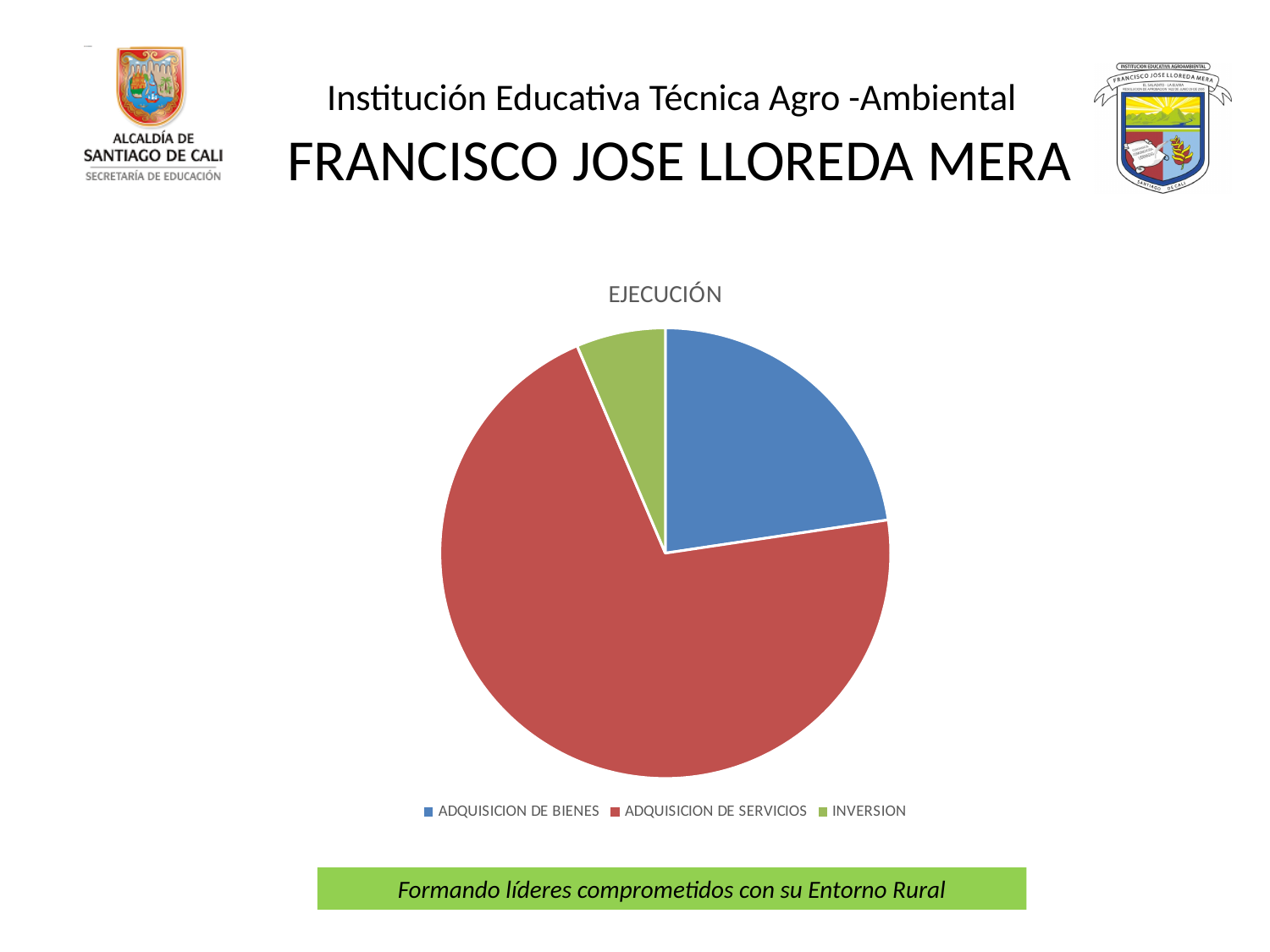
What kind of chart is shown on the slide? pie chart Which is larger, the slice for ADQUISICION DE BIENES or the slice for INVERSION? ADQUISICION DE BIENES What colour is the slice for ADQUISICION DE SERVICIOS? red Which is larger, the slice for ADQUISICION DE SERVICIOS or the slice for ADQUISICION DE BIENES? ADQUISICION DE SERVICIOS How many slices does the pie chart have? 3 Which category has the largest slice of the pie? ADQUISICION DE SERVICIOS Which category has the smallest slice of the pie? INVERSION What is the title of the chart? EJECUCIÓN How many entries does the legend list? 3